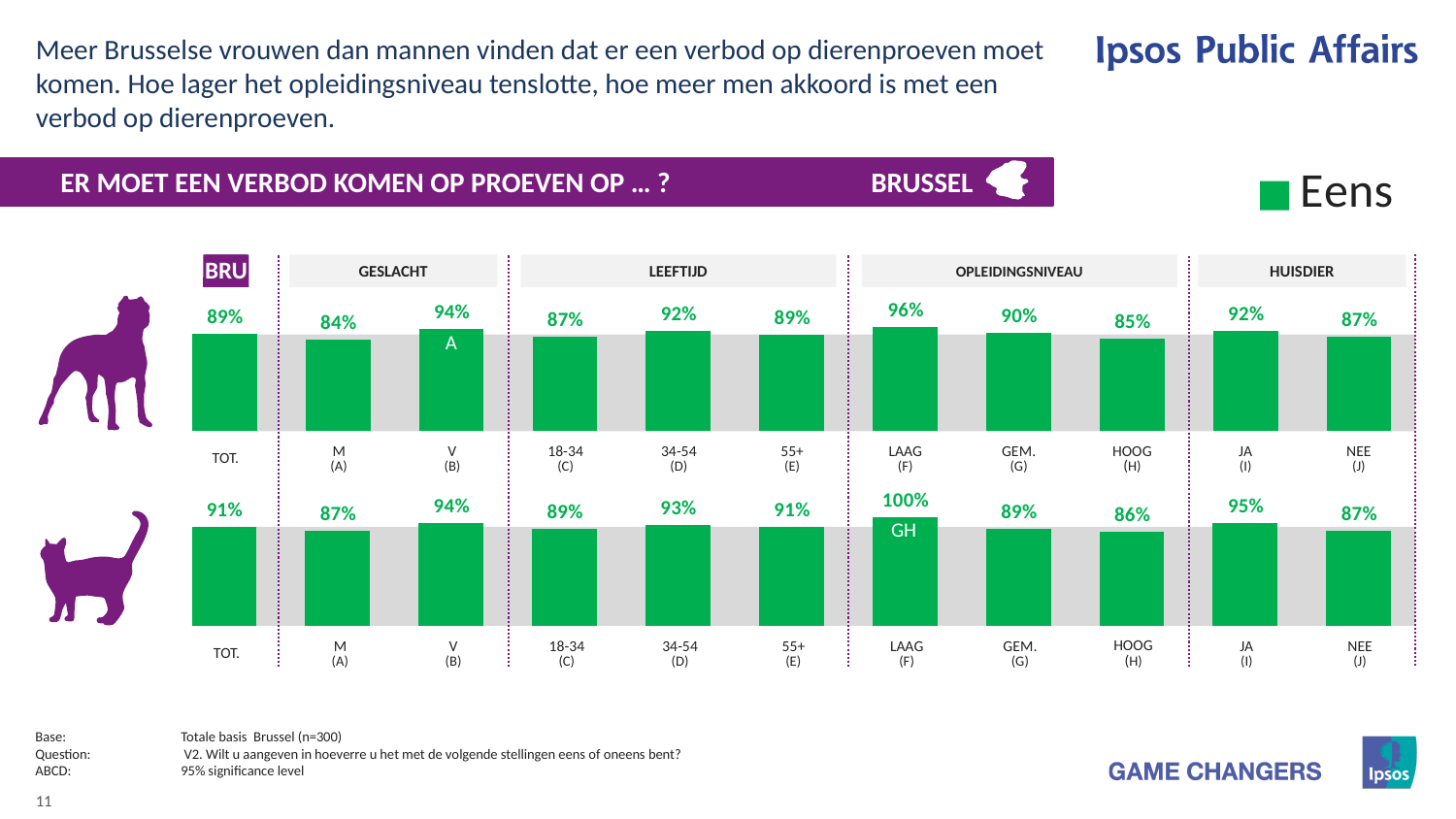
In the bottom row of bars (cat icon), which category has the lowest value? HOOG (H) In the bottom row of bars (cat icon), what is the value for LAAG (F)? 100% In the top row of bars (dog icon), what is the value for TOT.? 89% In the bottom row of bars (cat icon), which is larger: 34-54 (D) or 55+ (E)? 34-54 (D) In the bottom row of bars (cat icon), what is the difference between LAAG (F) and HOOG (H)? 14% In the top row of bars (dog icon), which category has the highest value? LAAG (F) In the top row of bars (dog icon), which category has the lowest value? M (A) In the top row of bars (dog icon), what is the difference between V (B) and M (A)? 10% In the top row of bars (dog icon), do the values fall from LAAG to GEM. to HOOG under OPLEIDINGSNIVEAU? Yes In the bottom row of bars (cat icon), what is the value for JA (I) under HUISDIER? 95% What series does the legend show? Eens In the top row of bars (dog icon), what is the value for V (B) under GESLACHT? 94%